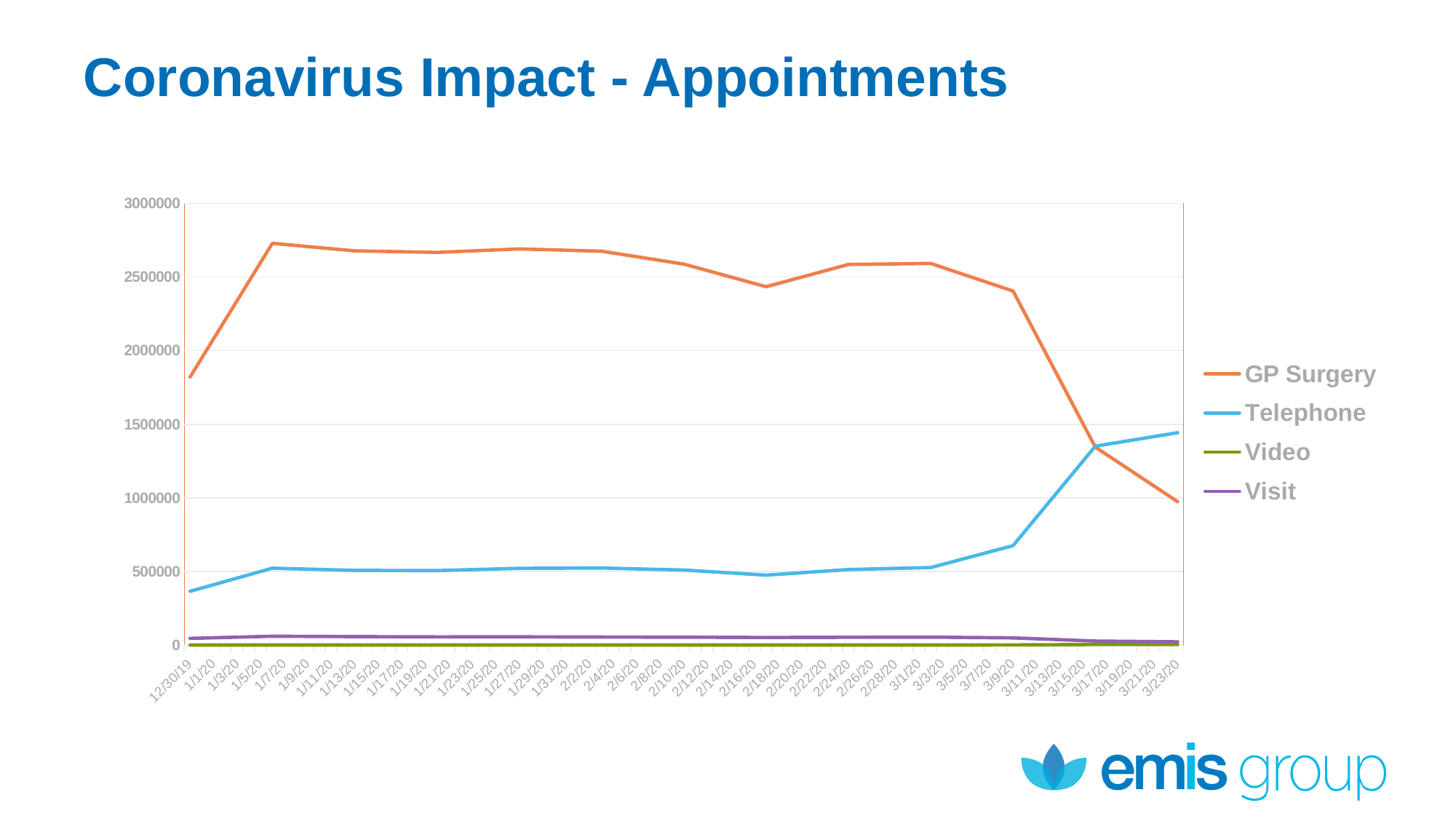
What is the title of the slide? Coronavirus Impact - Appointments Is the value for Telephone on 12/30/19 greater or less than 500000? less What kind of chart is shown on the slide? line chart Is the value for Telephone on 3/9/20 greater or less than 500000? greater Does the GP Surgery line rise or fall between 3/9/20 and 3/23/20? fall How many series does the legend list? 4 Is the value for GP Surgery on 1/7/20 greater or less than 2500000? greater Does the Telephone line rise or fall between 3/3/20 and 3/23/20? rise Which series has the highest value on 3/23/20? Telephone Which series has the highest value on 1/7/20? GP Surgery Which is larger on 2/18/20, GP Surgery or Telephone? GP Surgery